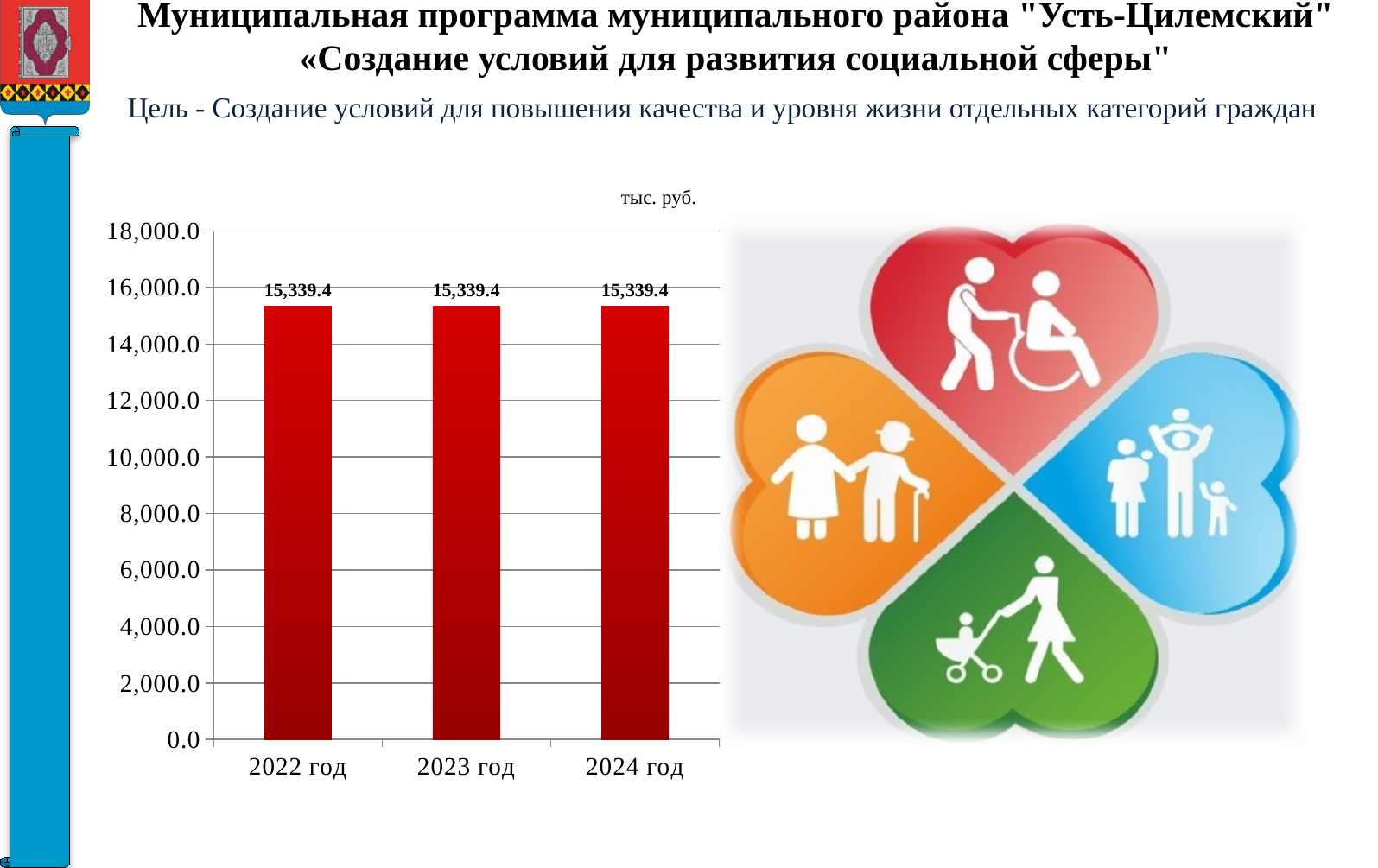
What is the highest value shown on the vertical axis of the chart? 18,000.0 What unit is indicated above the chart? тыс. руб. Do the values rise, fall or stay the same from 2022 год to 2024 год? stay the same What kind of chart is shown on the slide? bar chart What colour are the bars in the chart? red What is the value for 2024 год? 15,339.4 Is the value for 2022 год greater or less than 16,000.0? less What is the difference between the values for 2022 год and 2024 год? 0.0 How many categories are shown on the x axis of the chart? 3 Is the value for 2023 год greater or less than 14,000.0? greater What is the value for 2023 год? 15,339.4 What is the value for 2022 год? 15,339.4